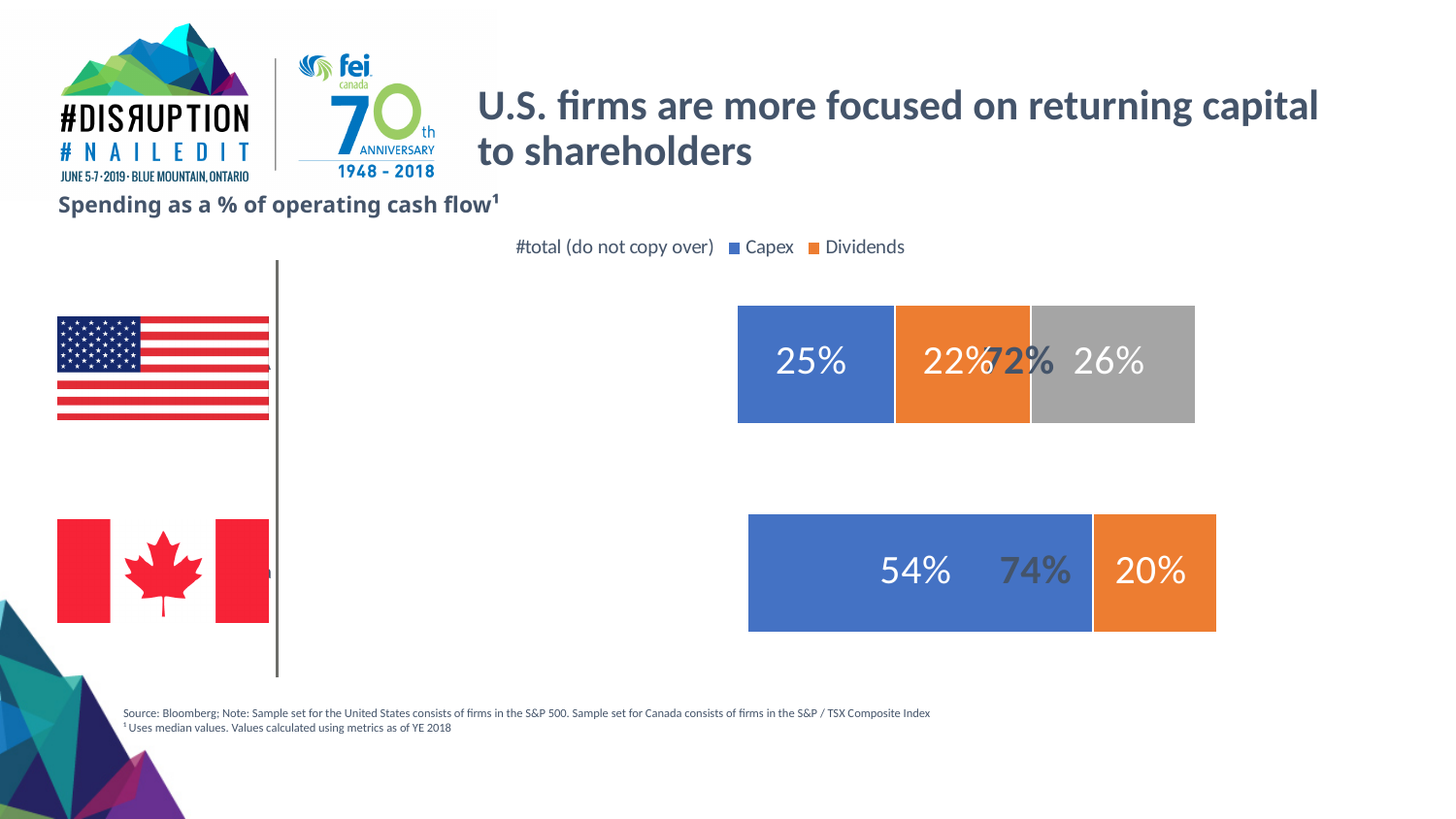
What is the Dividends value for the bar with the U.S. flag? 22% What is the total of the Capex and Dividends segments for the bar with the Canadian flag? 74% What kind of chart is shown on the slide? Bar chart What is the Capex value for the bar with the Canadian flag? 54% What is the difference between Canada's Capex value and the U.S. Capex value? 29 percentage points What is the Capex value for the bar with the U.S. flag? 25% Which country has the higher Dividends value, the U.S. or Canada? U.S. How many entries does the chart legend list? 3 How many countries (bars) are shown in the chart? 2 What is the Dividends value for the bar with the Canadian flag? 20% Which country has the higher Capex value, the U.S. or Canada? Canada What colour represents Capex in the chart? Blue